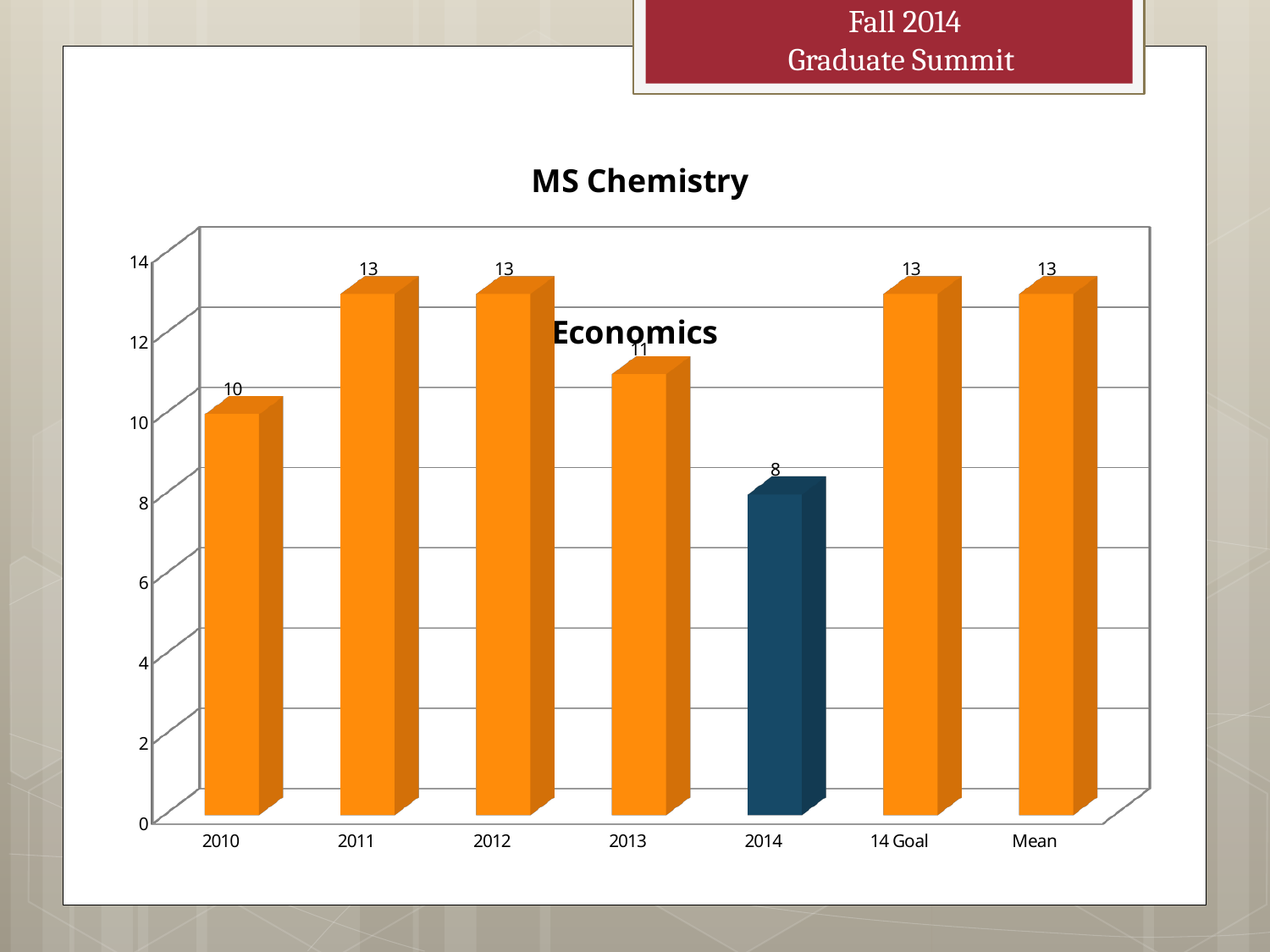
What kind of chart is shown on the slide? bar chart What is the difference between the 2011 value and the 2010 value? 3 Do the values rise or fall from 2011 to 2014? fall What is the value for 2010 in the MS Chemistry chart? 10 What is the value for 2013 in the MS Chemistry chart? 11 Which category has the lowest value in the MS Chemistry chart? 2014 Which is larger, the value for 2013 or the value for 2014? 2013 What is the value for 14 Goal in the MS Chemistry chart? 13 How many categories are shown on the x axis of the chart? 7 Which bar in the chart is coloured differently from the others? 2014 What is the value for 2014 in the MS Chemistry chart? 8 What is the difference between the 14 Goal value and the 2014 value? 5